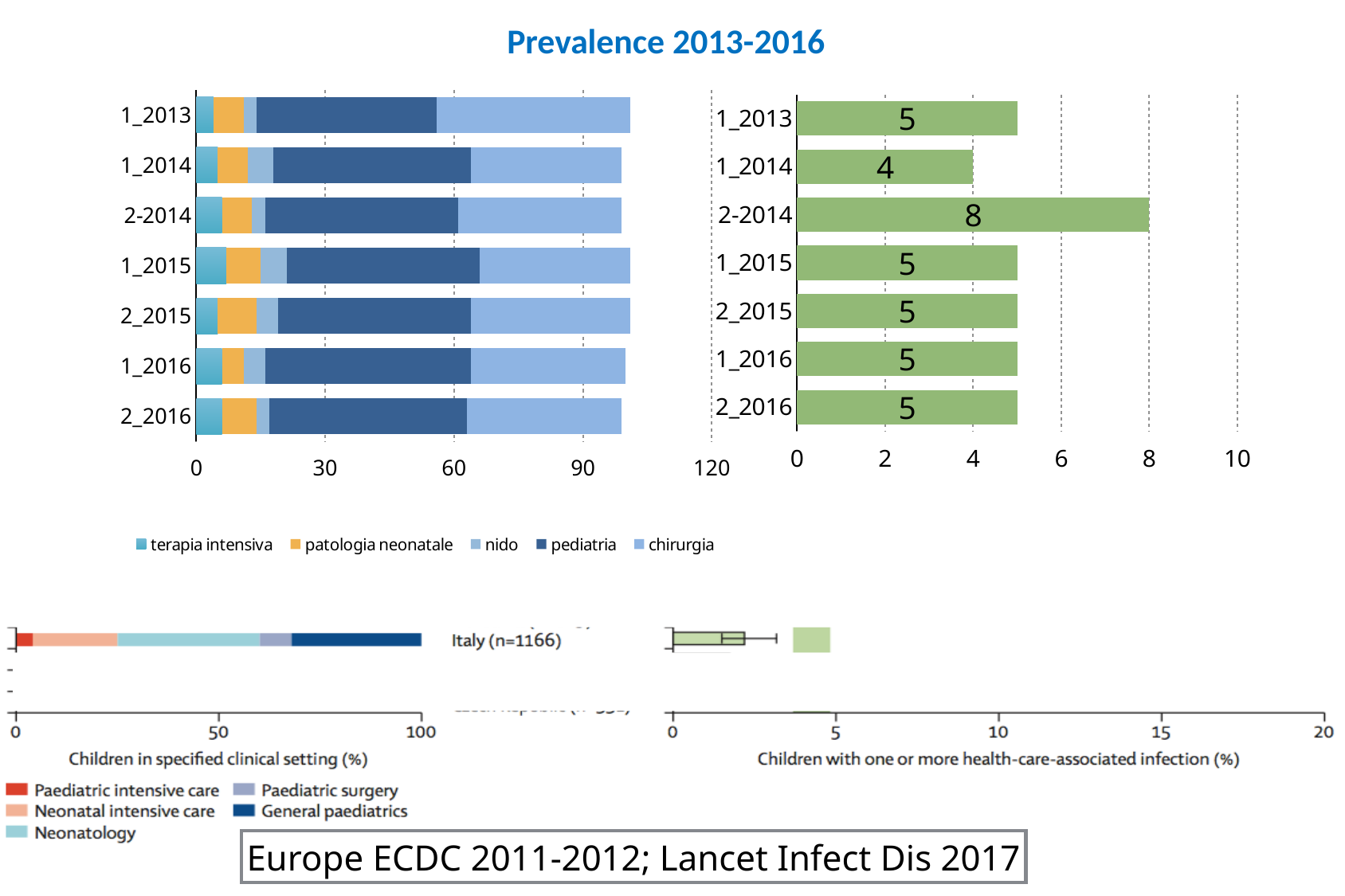
In the green bar chart on the right, what is the value for 2-2014? 8 How many categories are shown in the green bar chart on the right? 7 In the green bar chart on the right, is the value for 2-2014 greater or less than 6? greater In the green bar chart on the right, which category has the lowest value? 1_2014 In the green bar chart on the right, which is larger, the value for 1_2013 or the value for 1_2014? 1_2013 What is the title shown above the two charts at the top of the slide? Prevalence 2013-2016 How many series does the legend of the stacked bar chart on the left list? 5 In the green bar chart on the right, what is the value for 1_2014? 4 In the green bar chart on the right, what is the value for 2_2016? 5 In the green bar chart on the right, which category has the highest value? 2-2014 What kind of chart is the green chart on the right? bar chart In the green bar chart on the right, what is the difference between the values for 2-2014 and 1_2014? 4